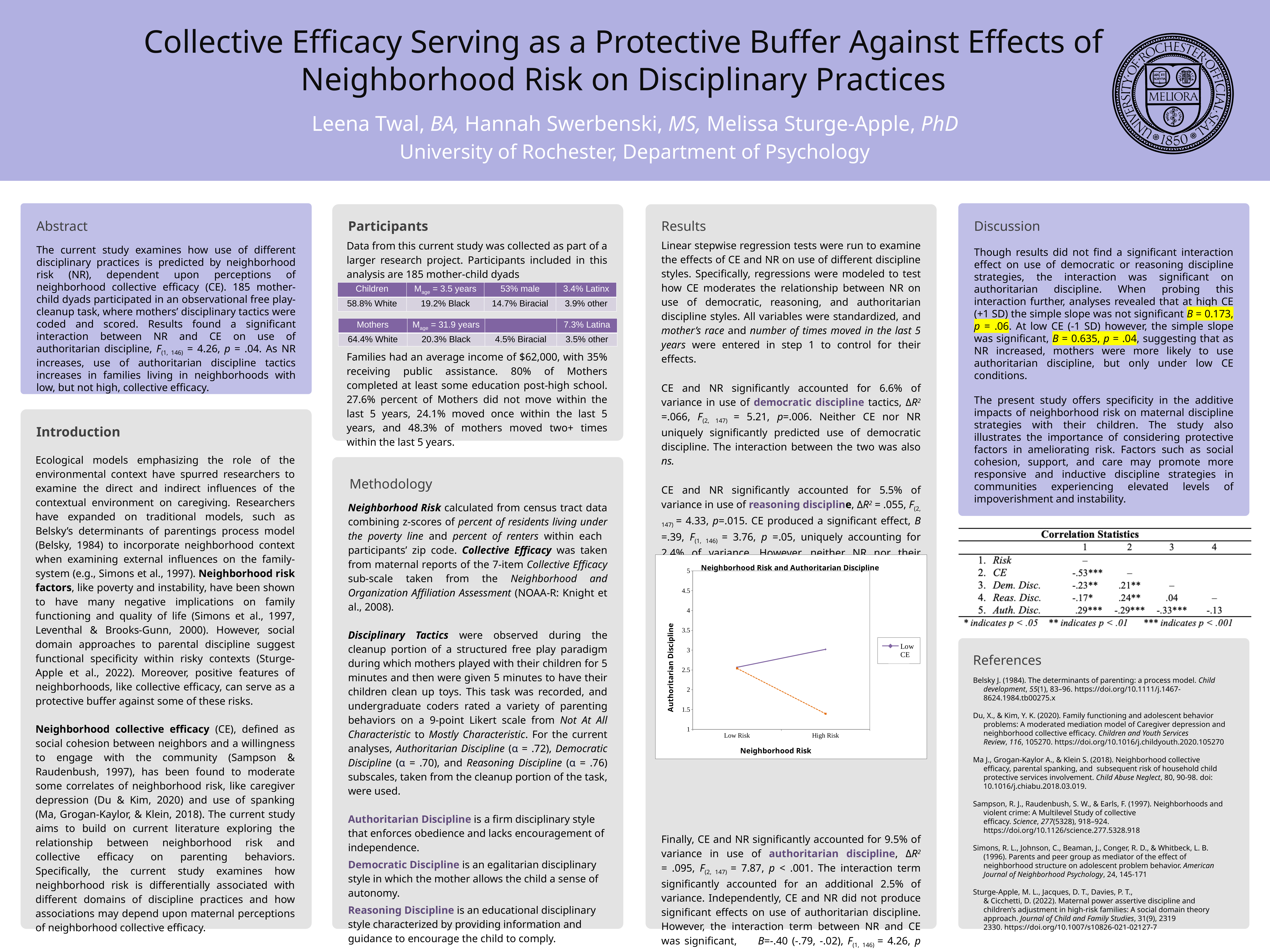
What kind of chart is shown on the slide? line chart How many categories are shown on the x axis of the chart? 2 How many lines are plotted on the chart? 2 Does the orange dashed line rise or fall from Low Risk to High Risk? fall What is the title of the chart on the slide? Neighborhood Risk and Authoritarian Discipline Is the value of the orange dashed line at High Risk greater or less than 2? less At High Risk, which line is higher: the Low CE line or the orange dashed line? Low CE What is the label of the y axis of the chart? Authoritarian Discipline What is the highest value shown on the y axis of the chart? 5 Is the value of the Low CE line at High Risk greater or less than 4? less Is the value of the Low CE line at Low Risk greater or less than 2? greater Does the Low CE line rise or fall from Low Risk to High Risk? rise